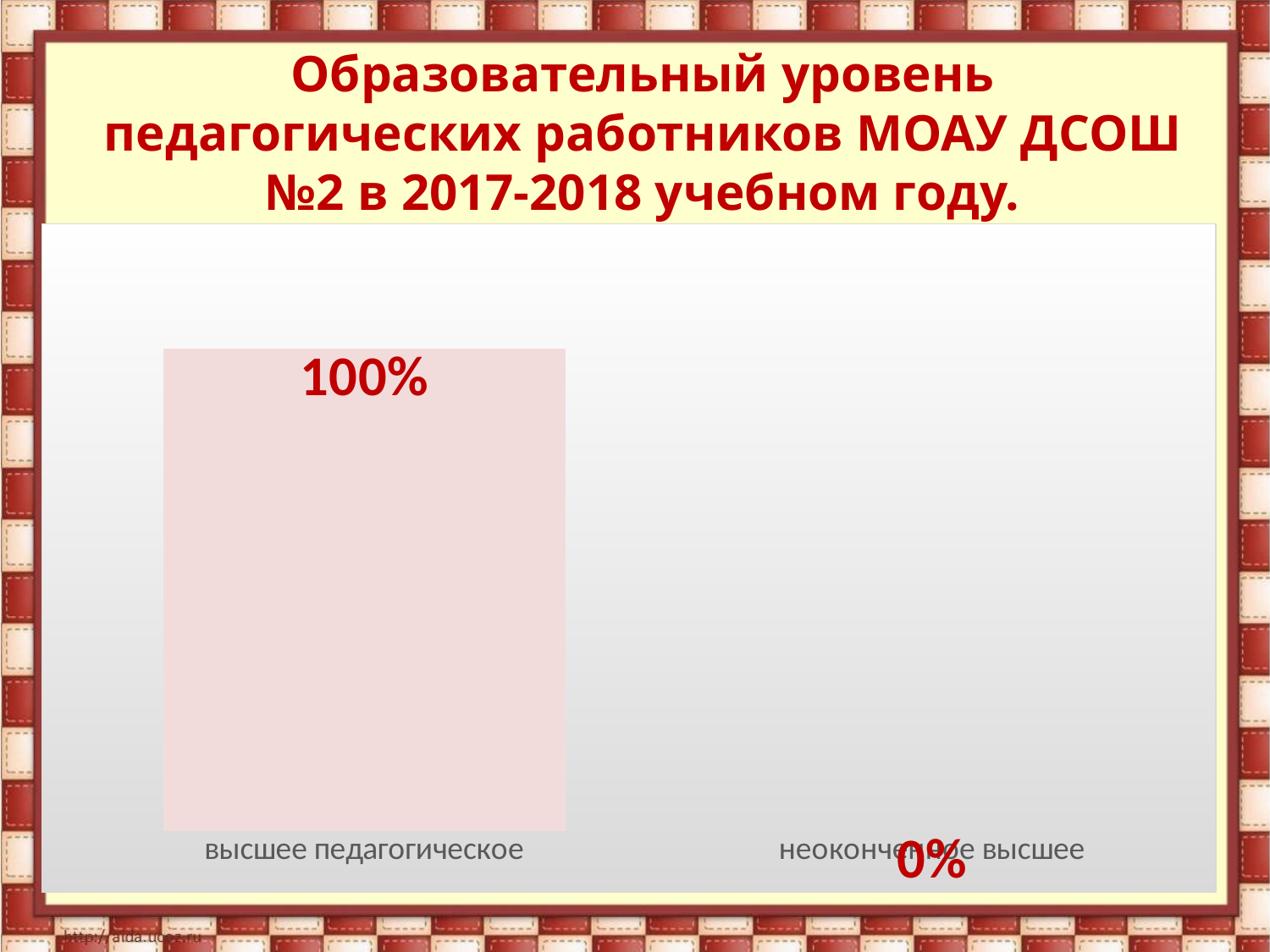
What kind of chart is shown on the slide? bar chart How many categories are shown in the chart? 2 Do the values rise or fall from left to right along the x axis? fall What is the total of the two values shown in the chart? 100% Which is larger, the value for "высшее педагогическое" or for "неоконченное высшее"? высшее педагогическое What is the value for "высшее педагогическое"? 100% Which category has the highest value? высшее педагогическое Which category has the lowest value? неоконченное высшее What is the title of the slide containing the chart? Образовательный уровень педагогических работников МОАУ ДСОШ №2 в 2017-2018 учебном году. What is the value for "неоконченное высшее"? 0% What is the label of the left-hand category in the chart? высшее педагогическое What is the difference between the values for "высшее педагогическое" and "неоконченное высшее"? 100%